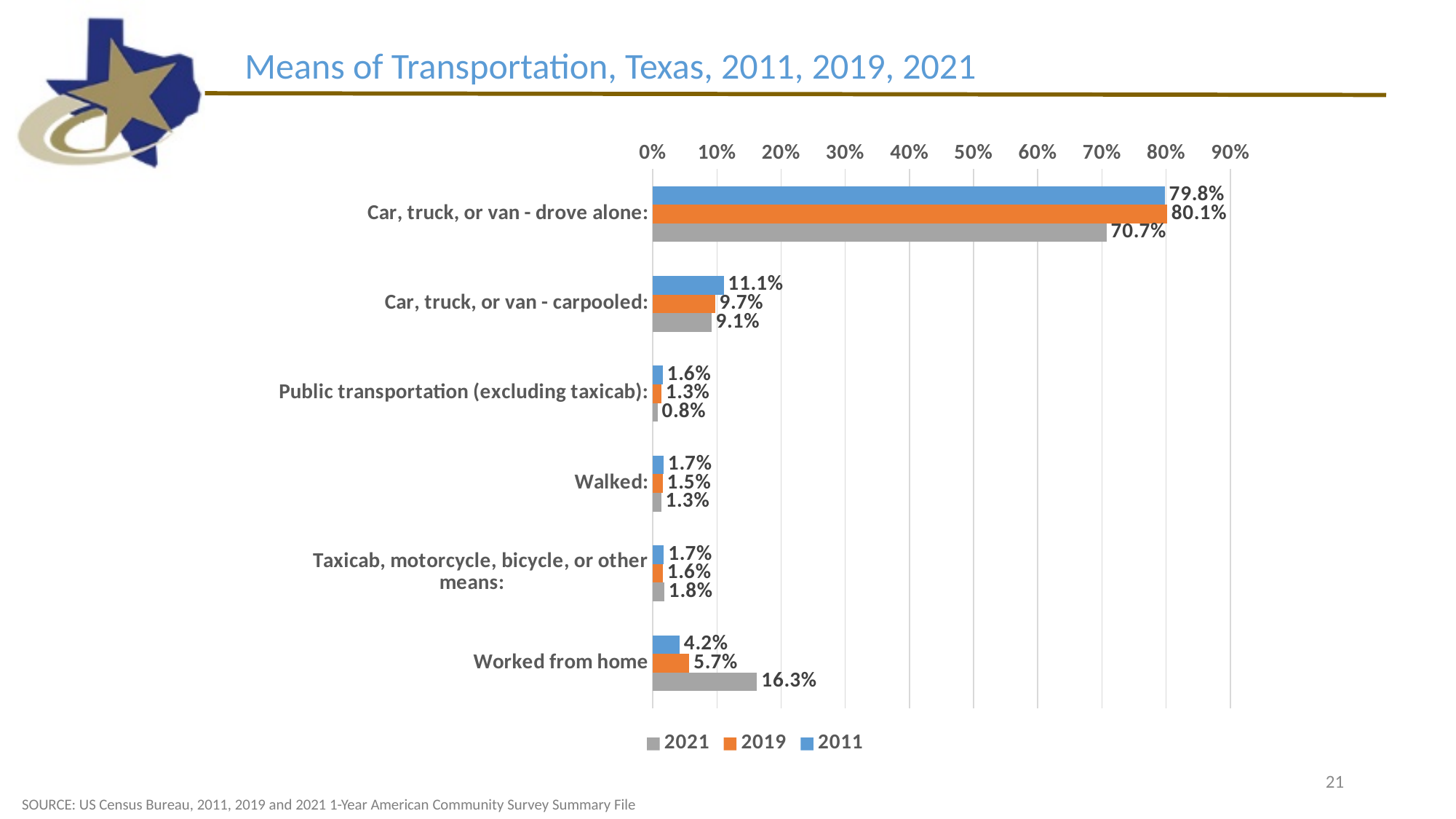
What was the share of workers using public transportation (excluding taxicab) in 2021? 0.8% How many years (series) does the legend list? 3 Which means of transportation had the highest share in 2021? Car, truck, or van - drove alone How many means of transportation categories are shown on the chart? 6 By how many percentage points did the share of workers who worked from home change from 2019 to 2021? 10.6 percentage points Which means of transportation had the lowest share in 2011? Public transportation (excluding taxicab) What was the share of workers who carpooled in 2011? 11.1% What type of chart is shown on the slide? Bar chart Was the share of workers who walked higher in 2011 or in 2021? 2011 What was the share of workers who worked from home in 2021? 16.3% What was the share of workers who drove alone in a car, truck, or van in 2019? 80.1% What is the difference between the 2011 and 2021 shares for driving alone? 9.1 percentage points